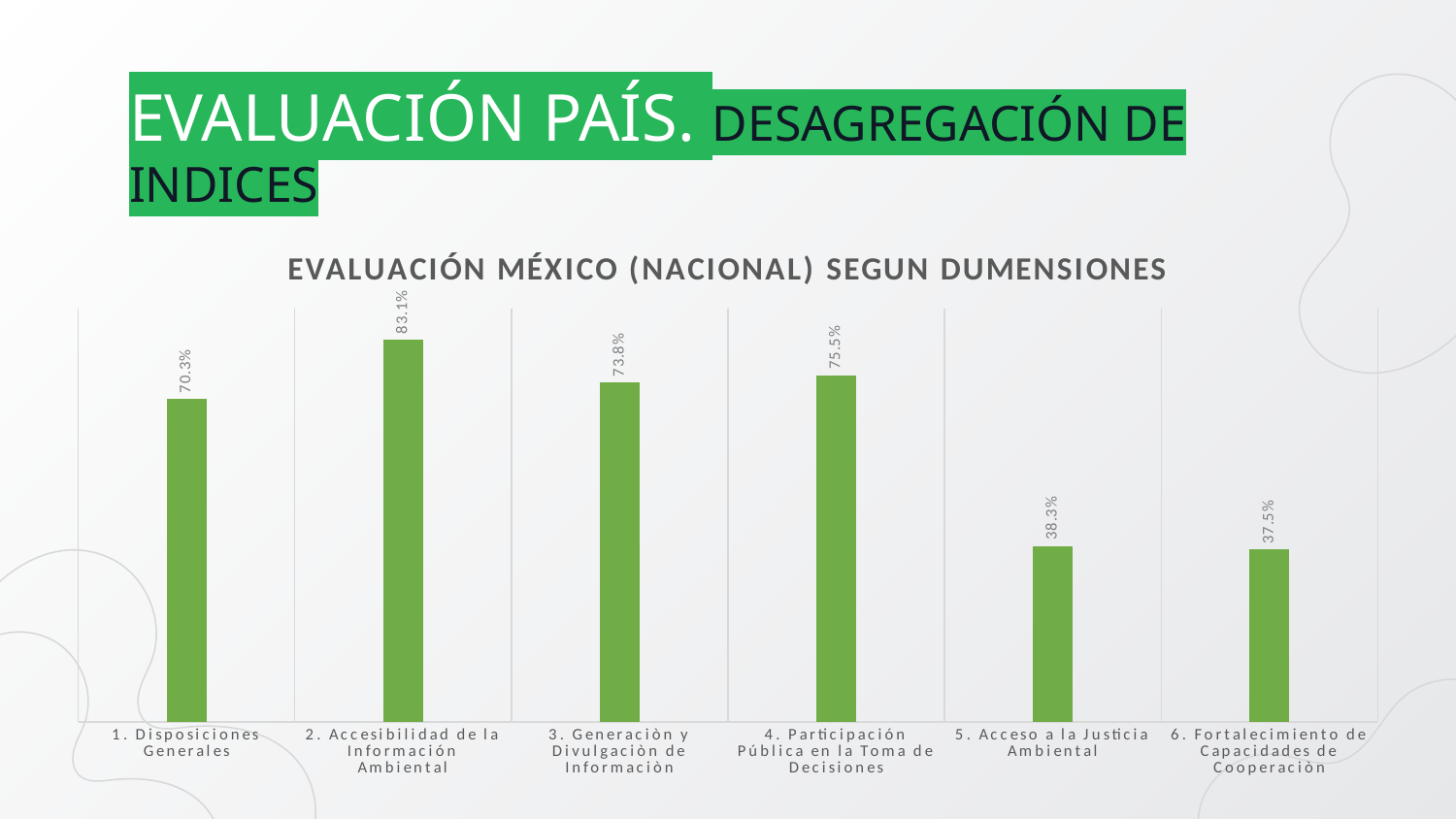
What is the title of the chart? EVALUACIÓN MÉXICO (NACIONAL) SEGUN DUMENSIONES What colour are the bars in the chart? Green What is the value for "1. Disposiciones Generales"? 70.3% Which dimension has the lowest value? 6. Fortalecimiento de Capacidades de Cooperaciòn Which is larger, the value for "1. Disposiciones Generales" or the value for "3. Generaciòn y Divulgaciòn de Informaciòn"? 3. Generaciòn y Divulgaciòn de Informaciòn How many dimensions are shown on the chart? 6 What kind of chart is shown on the slide? Bar chart Which dimension has the highest value? 2. Accesibilidad de la Información Ambiental What is the difference between the values for "4. Participación Pública en la Toma de Decisiones" and "3. Generaciòn y Divulgaciòn de Informaciòn"? 1.7% What is the difference between the values for "2. Accesibilidad de la Información Ambiental" and "6. Fortalecimiento de Capacidades de Cooperaciòn"? 45.6% What is the value for "5. Acceso a la Justicia Ambiental"? 38.3% What is the value for "2. Accesibilidad de la Información Ambiental"? 83.1%